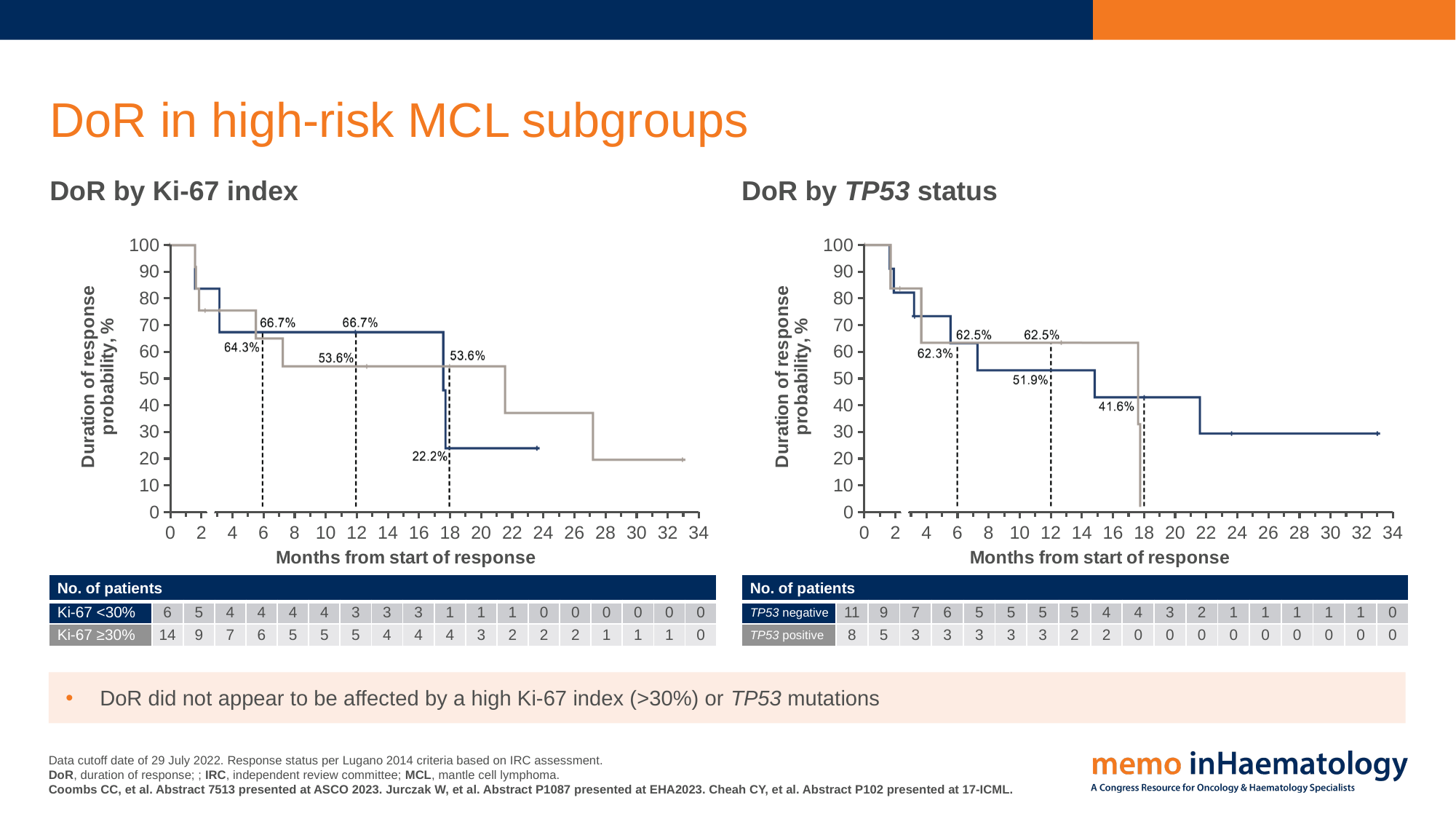
In the 'DoR by Ki-67 index' chart, what is the duration of response probability at 18 months for the Ki-67 <30% group? 22.2% What kind of chart is the 'DoR by Ki-67 index' chart? line chart What is the x-axis label of the 'DoR by Ki-67 index' chart? Months from start of response In the 'DoR by TP53 status' chart, what is the duration of response probability at 18 months for the TP53 negative group? 41.6% In the 'DoR by TP53 status' chart, what is the duration of response probability at 12 months for the TP53 positive group? 62.5% In the 'DoR by TP53 status' chart, is the TP53 negative curve at 24 months greater or less than 40? less In the 'DoR by Ki-67 index' chart, what is the difference between the Ki-67 ≥30% and Ki-67 <30% groups at 18 months? 31.4 percentage points In the 'DoR by Ki-67 index' chart, what is the duration of response probability at 12 months for the Ki-67 ≥30% group? 53.6% In the 'DoR by TP53 status' chart, what is the duration of response probability at 12 months for the TP53 negative group? 51.9% In the 'DoR by Ki-67 index' chart, which group has the higher duration of response probability at 12 months? Ki-67 <30% In the 'DoR by Ki-67 index' chart, what is the duration of response probability at 6 months for the Ki-67 <30% group? 66.7% In the 'DoR by TP53 status' chart, how many patients were in the TP53 negative group at 0 months? 11